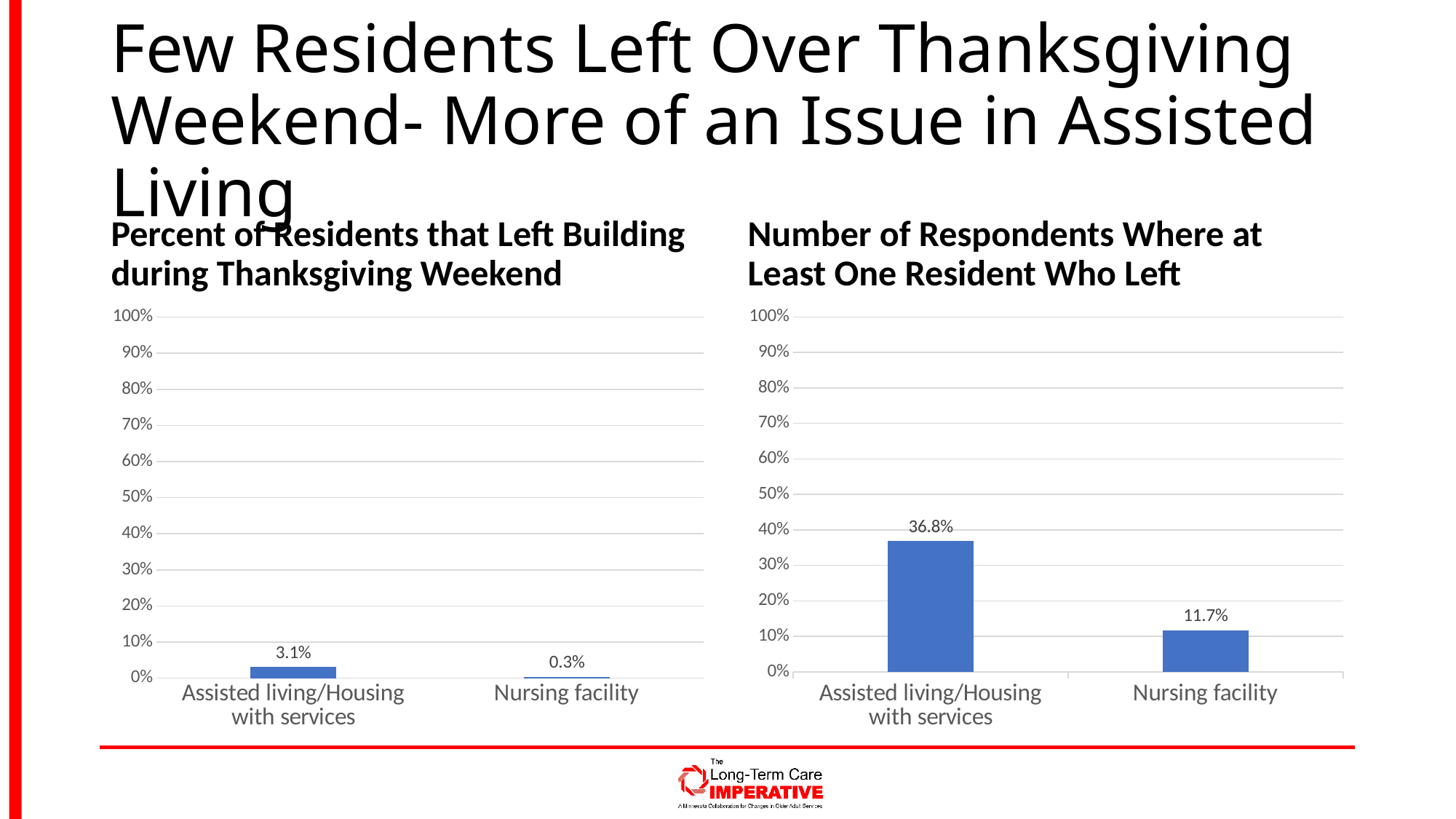
In the 'Number of Respondents Where at Least One Resident Who Left' chart, what is the value for Assisted living/Housing with services? 36.8% In the 'Percent of Residents that Left Building during Thanksgiving Weekend' chart, what is the value for Nursing facility? 0.3% What kind of chart is the 'Number of Respondents Where at Least One Resident Who Left' chart? Bar chart In the 'Number of Respondents Where at Least One Resident Who Left' chart, what is the highest value shown on the y axis? 100% In the 'Number of Respondents Where at Least One Resident Who Left' chart, which category has the highest value? Assisted living/Housing with services In the 'Number of Respondents Where at Least One Resident Who Left' chart, what is the difference between the Assisted living/Housing with services value and the Nursing facility value? 25.1% In the 'Percent of Residents that Left Building during Thanksgiving Weekend' chart, what is the difference between the Assisted living/Housing with services value and the Nursing facility value? 2.8% In the 'Number of Respondents Where at Least One Resident Who Left' chart, what is the value for Nursing facility? 11.7% In the 'Number of Respondents Where at Least One Resident Who Left' chart, is the value for Assisted living/Housing with services greater or less than 30%? greater In the 'Percent of Residents that Left Building during Thanksgiving Weekend' chart, what is the value for Assisted living/Housing with services? 3.1% In the 'Percent of Residents that Left Building during Thanksgiving Weekend' chart, which category has the lowest value? Nursing facility In the 'Percent of Residents that Left Building during Thanksgiving Weekend' chart, how many categories are shown on the x axis? 2